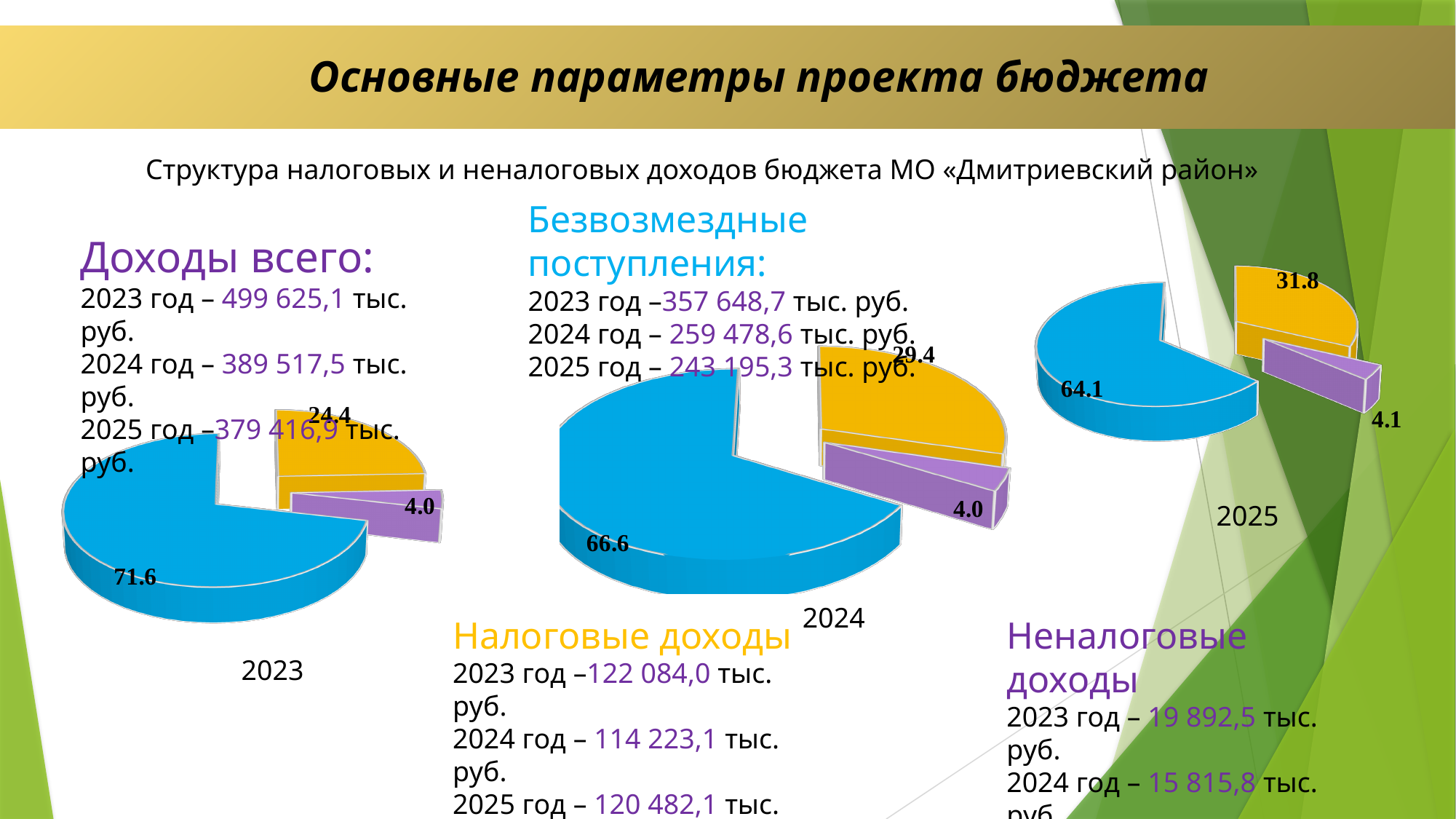
In the pie chart labelled 2023, which slice has the smallest value? the purple slice (4.0) In the pie chart labelled 2025, which slice has the largest value? the blue slice (64.1) In the pie chart labelled 2024, what value is shown on the yellow slice? 29.4 Which is larger: the yellow slice in the 2023 pie chart or the yellow slice in the 2025 pie chart? the yellow slice in the 2025 pie chart (31.8) In the pie chart labelled 2024, what is the difference between the blue slice value and the yellow slice value? 37.2 Across the pie charts for 2023, 2024 and 2025, does the value of the blue slice rise or fall? fall How many pie charts are shown on the slide? 3 What kind of chart is used to show the 2023 data? pie chart In the pie chart labelled 2023, what is the sum of the yellow and purple slice values? 28.4 In the pie chart labelled 2023, what value is shown on the blue slice? 71.6 How many slices does the pie chart labelled 2024 have? 3 In the pie chart labelled 2025, what value is shown on the purple slice? 4.1